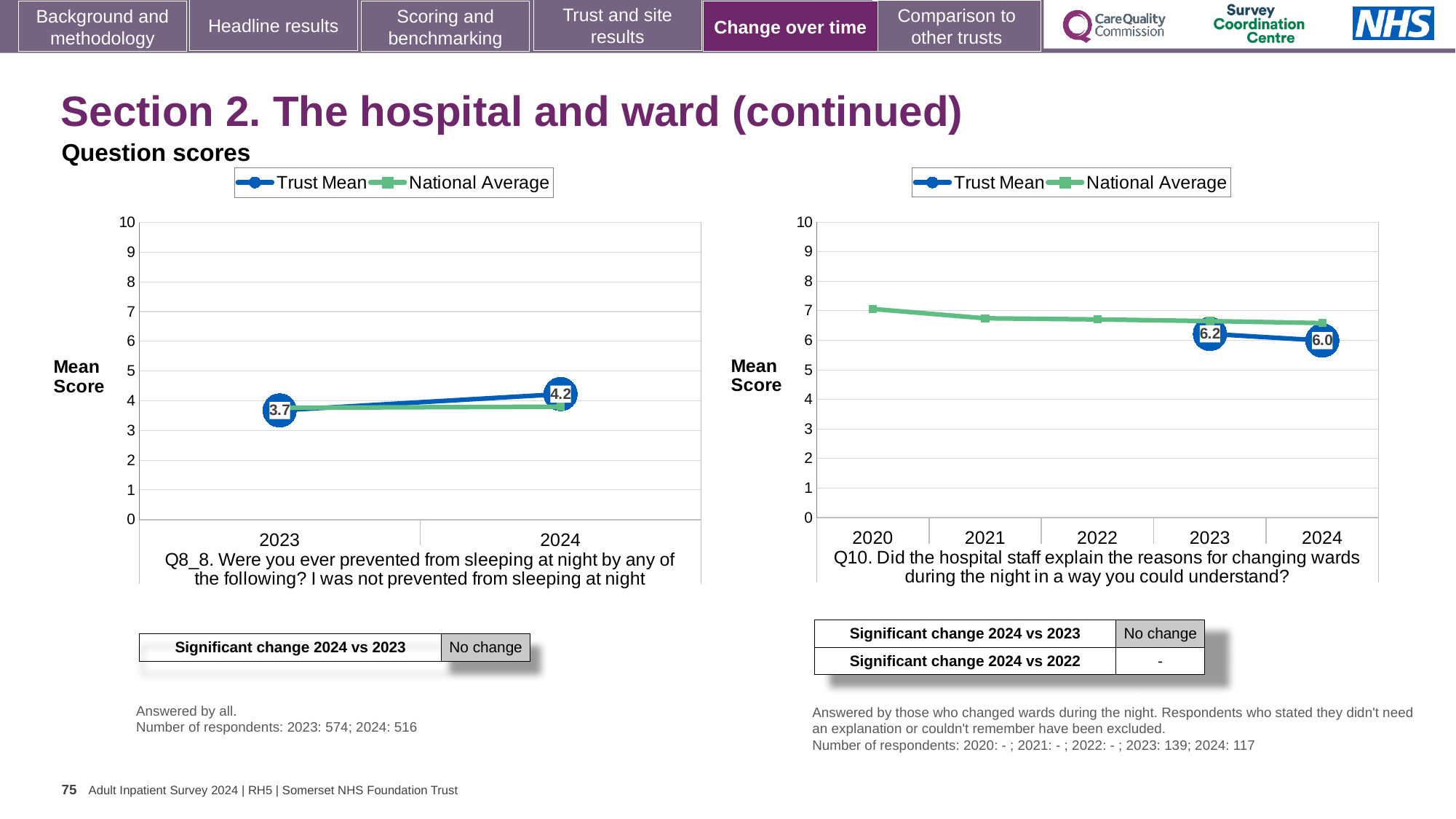
How many years are shown on the x axis of the right chart (Q10)? 5 On the right chart (Q10), what is the difference between the Trust Mean in 2023 and 2024? 0.2 On the right chart (Q10), what is the Trust Mean score for 2023? 6.2 On the left chart (Q8_8), what is the Trust Mean score for 2023? 3.7 On the right chart (Q10), does the Trust Mean rise or fall from 2023 to 2024? fall On the left chart (Q8_8), does the Trust Mean rise or fall from 2023 to 2024? rise On the left chart (Q8_8), by how much did the Trust Mean change from 2023 to 2024? 0.5 On the left chart (Q8_8), what is the Trust Mean score for 2024? 4.2 On the right chart (Q10), what is the Trust Mean score for 2024? 6.0 What kind of chart is the right chart (Q10)? line chart On the right chart (Q10), is the National Average for 2020 greater or less than 6? greater How many series does the legend of the left chart (Q8_8) list? 2